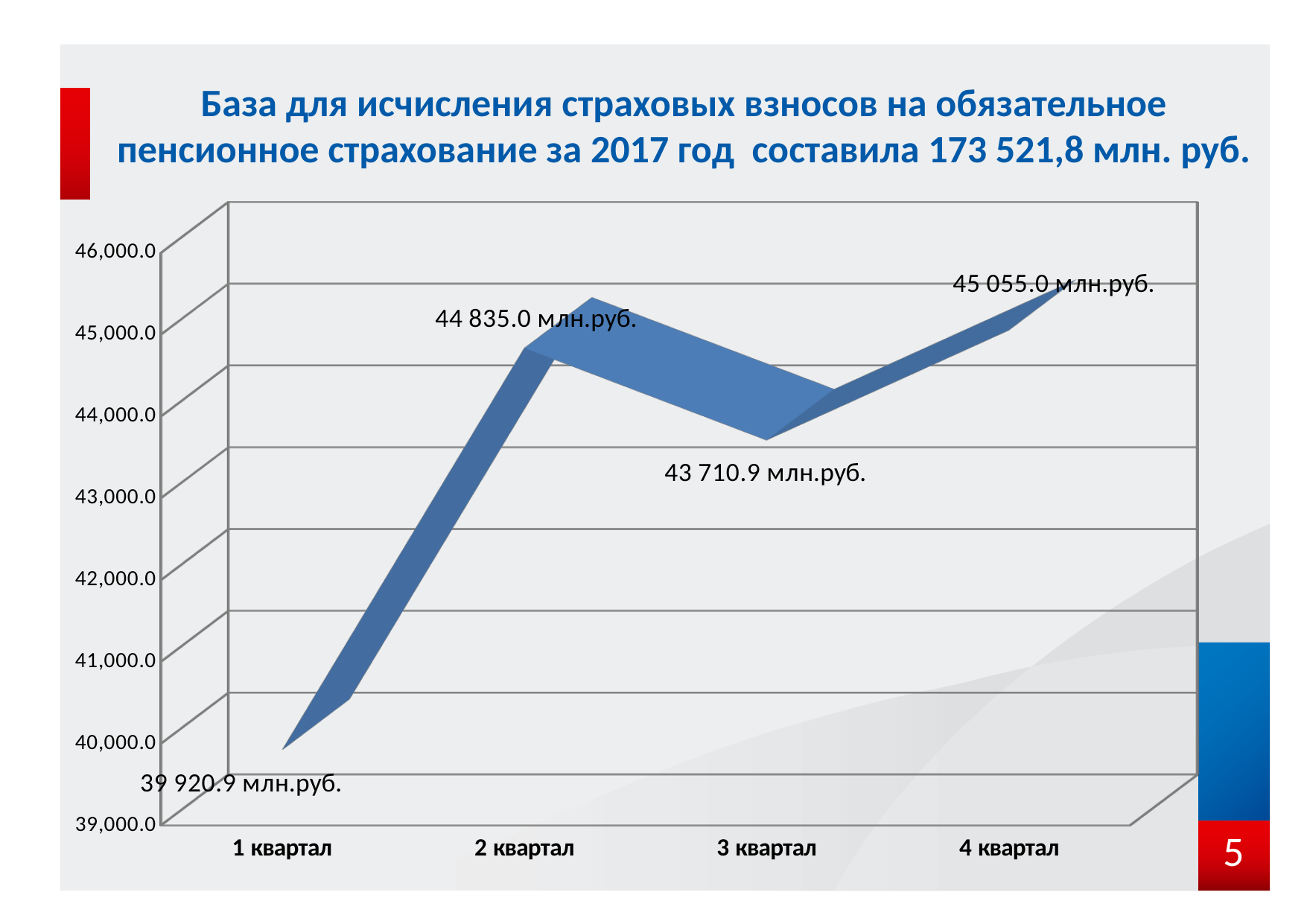
What kind of chart is shown on the slide? line chart What is the value for 1 квартал? 39 920.9 млн.руб. How many quarters are plotted on the chart? 4 What is the value for 2 квартал? 44 835.0 млн.руб. What is the value for 3 квартал? 43 710.9 млн.руб. What is the value for 4 квартал? 45 055.0 млн.руб. Which quarter has the lowest value? 1 квартал What is the difference between the values for 4 квартал and 3 квартал? 1 344.1 млн.руб. Which quarter has the highest value? 4 квартал What is the difference between the values for 2 квартал and 1 квартал? 4 914.1 млн.руб. Which is larger, the value for 2 квартал or the value for 3 квартал? 2 квартал Is the value for 1 квартал greater or less than 41,000.0? less